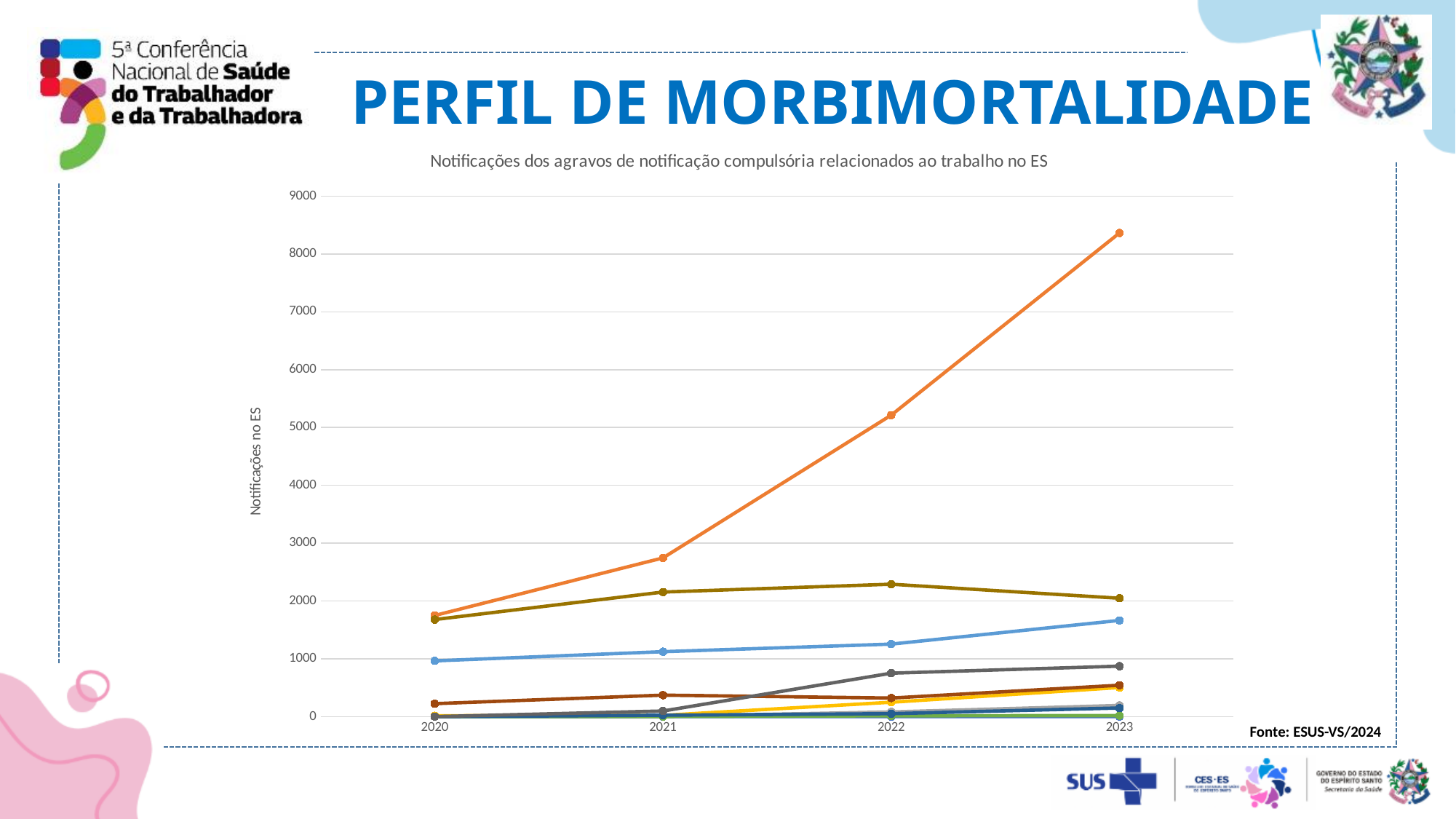
In which year does the orange line reach its highest value? 2023 Is the value of the light blue line in 2023 greater or less than 2000? less Is the value of the orange line in 2021 greater or less than 3000? less Is the value of the orange line in 2022 greater or less than 5000? greater How many years are shown on the x axis of the chart? 4 Does the orange line rise or fall from 2020 to 2023? rise What is the first year shown on the x axis? 2020 What kind of chart is shown on the slide? line chart What source is cited for the chart? ESUS-VS/2024 What is the title of the chart? Notificações dos agravos de notificação compulsória relacionados ao trabalho no ES